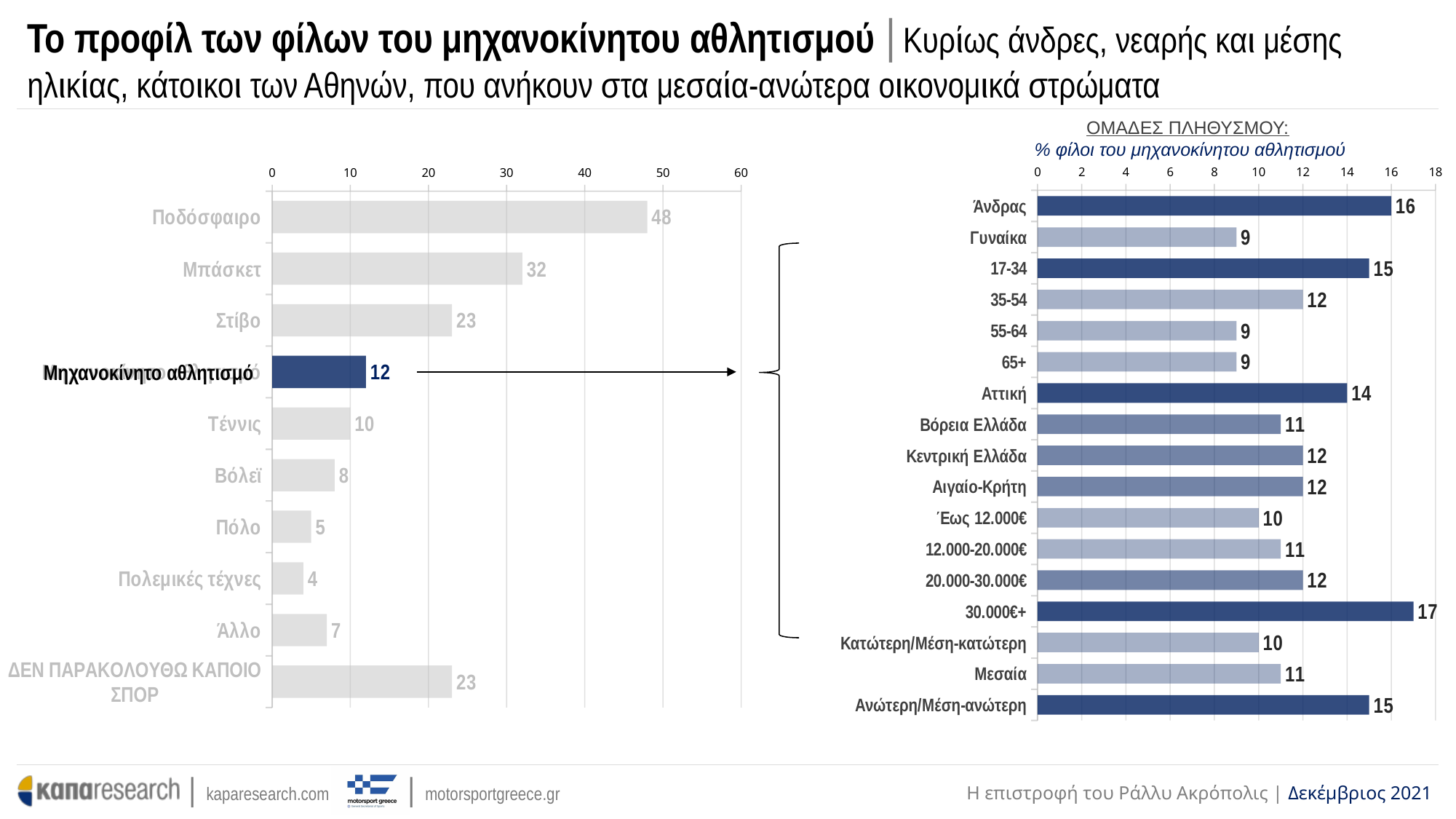
What kind of chart is the left chart? bar chart In the left chart, what is the difference between Ποδόσφαιρο and Μπάσκετ? 16 In the left chart, what is the value for Μηχανοκίνητο αθλητισμό? 12 In the right chart (ΟΜΑΔΕΣ ΠΛΗΘΥΣΜΟΥ), what is the value for Άνδρας? 16 In the left chart, how many categories are shown? 10 In the right chart (ΟΜΑΔΕΣ ΠΛΗΘΥΣΜΟΥ), what is the difference between 17-34 and 65+? 6 In the left chart, which category has the lowest value? Πολεμικές τέχνες In the right chart (ΟΜΑΔΕΣ ΠΛΗΘΥΣΜΟΥ), which category has the highest value? 30.000€+ In the right chart (ΟΜΑΔΕΣ ΠΛΗΘΥΣΜΟΥ), what is the value for Αττική? 14 In the left chart, what is the value for Ποδόσφαιρο? 48 In the right chart (ΟΜΑΔΕΣ ΠΛΗΘΥΣΜΟΥ), which is larger, Άνδρας or Γυναίκα? Άνδρας In the right chart (ΟΜΑΔΕΣ ΠΛΗΘΥΣΜΟΥ), how many categories are shown? 17